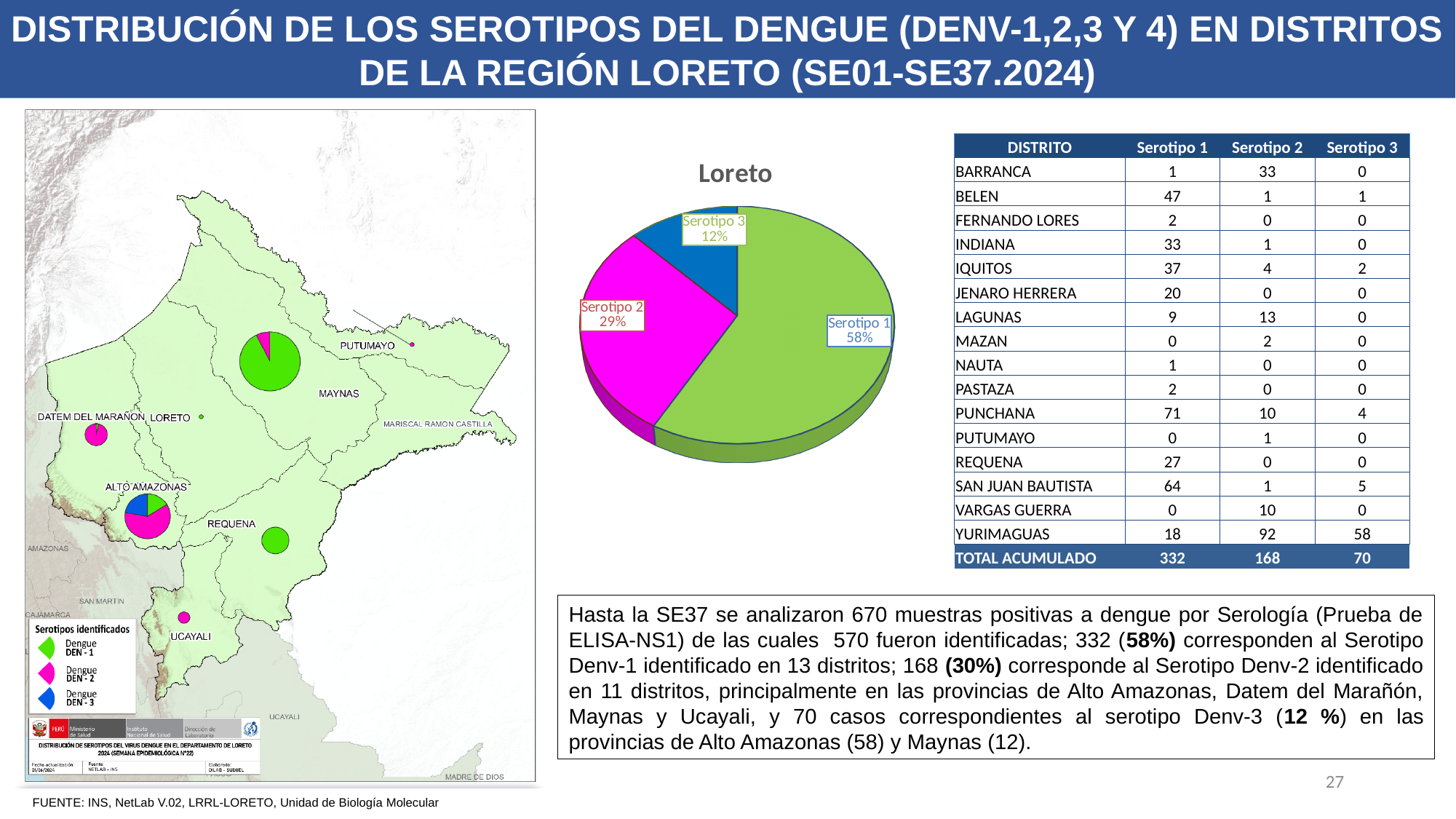
What type of chart is the chart titled Loreto? Pie chart Which serotype has the smallest slice in the Loreto pie chart? Serotipo 3 How many percentage points larger is the Serotipo 1 slice than the Serotipo 2 slice in the Loreto pie chart? 29 Which serotype has the largest slice in the Loreto pie chart? Serotipo 1 What percentage is shown for Serotipo 3 in the Loreto pie chart? 12% Is the Serotipo 1 slice of the Loreto pie chart greater or less than 50%? greater What share of the Loreto pie chart does Serotipo 1 represent? 58% How many slices does the Loreto pie chart have? 3 In the Loreto pie chart, which is larger: the slice for Serotipo 2 or the slice for Serotipo 3? Serotipo 2 What is the title of the pie chart on the slide? Loreto What colour is the Serotipo 2 slice in the Loreto pie chart? Magenta What percentage is shown for Serotipo 2 in the Loreto pie chart? 29%